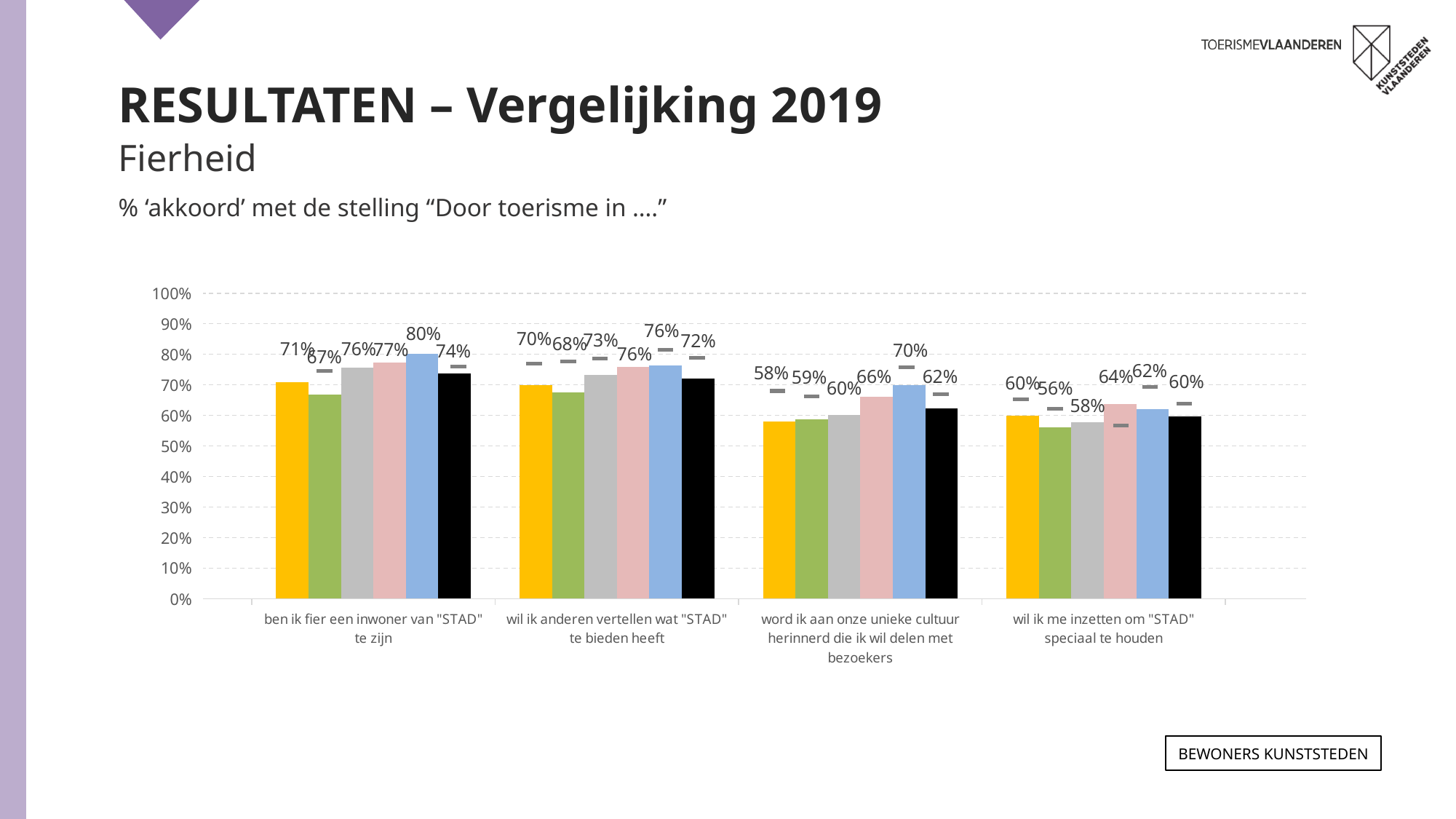
What is the value of the black bar for the statement "word ik aan onze unieke cultuur herinnerd die ik wil delen met bezoekers"? 62% What type of chart is shown on the slide? bar chart What is the highest value shown on the y axis of the chart? 100% How many bars are plotted for each statement category in the chart? 6 What is the value of the green bar for the statement "wil ik me inzetten om 'STAD' speciaal te houden"? 56% For the statement "wil ik me inzetten om 'STAD' speciaal te houden", which is larger: the pink bar or the blue bar? the pink bar (64%) What is the value of the yellow bar for the statement "wil ik anderen vertellen wat 'STAD' te bieden heeft"? 70% Which bar has the lowest value for the statement "ben ik fier een inwoner van 'STAD' te zijn"? the green bar (67%) What is the value of the blue bar for the statement "ben ik fier een inwoner van 'STAD' te zijn"? 80% Which bar has the highest value for the statement "word ik aan onze unieke cultuur herinnerd die ik wil delen met bezoekers"? the blue bar (70%) How many statement categories are shown along the x axis of the chart? 4 What is the difference between the blue bar and the green bar for the statement "ben ik fier een inwoner van 'STAD' te zijn"? 13 percentage points